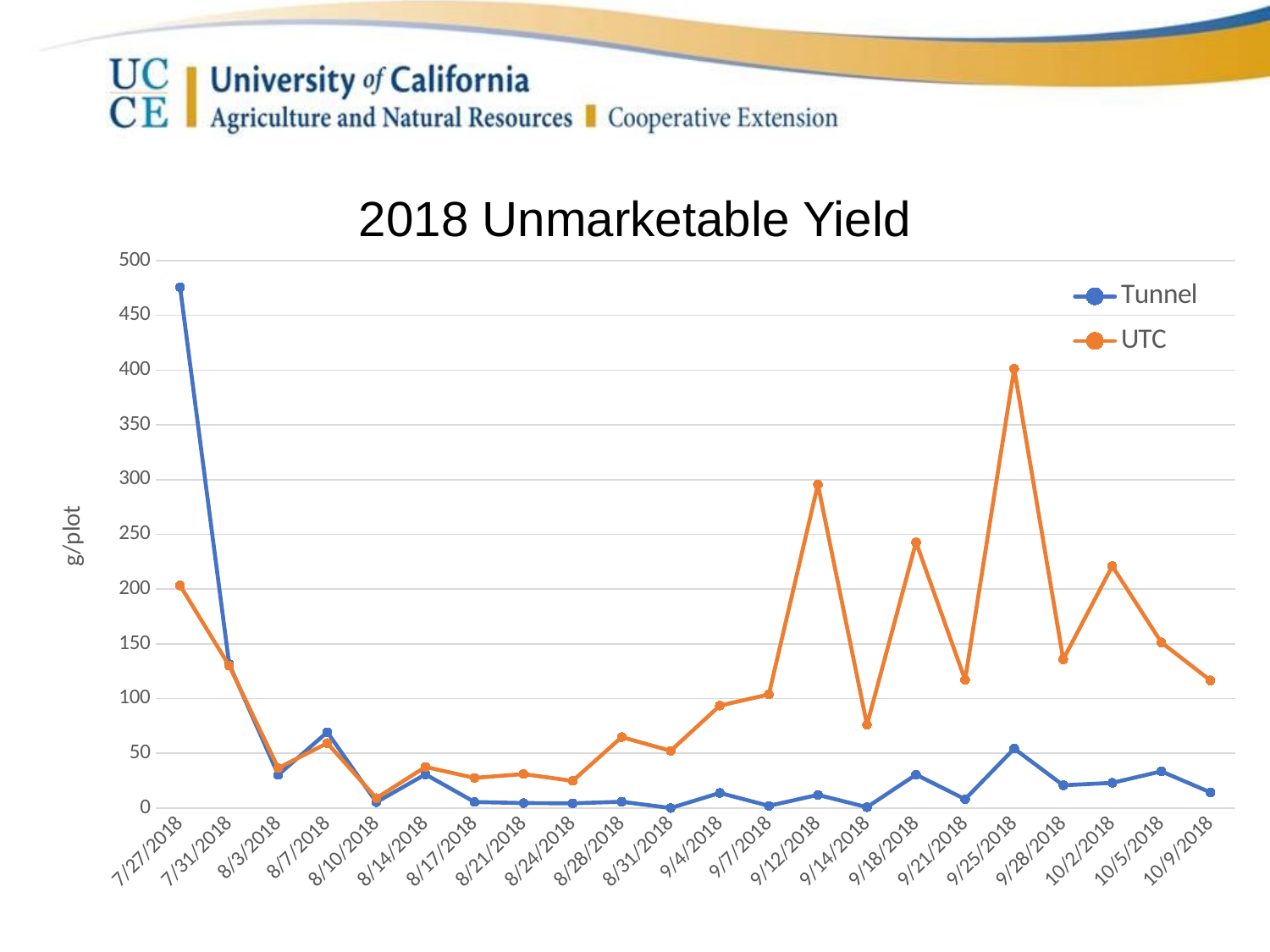
Is the Tunnel value on 9/25/2018 greater or less than 100? less Is the UTC value on 9/25/2018 greater or less than 350? greater Is the Tunnel value on 7/27/2018 greater or less than 450? greater On which date does the UTC series reach its highest value? 9/25/2018 How many dates are plotted along the x axis? 22 Does the Tunnel series rise or fall between 7/27/2018 and 8/3/2018? Fall What is the label on the y axis? g/plot On which date does the Tunnel series reach its highest value? 7/27/2018 How many series does the legend list? 2 What kind of chart is shown on the slide? Line chart On which date does the UTC series reach its lowest value? 8/10/2018 On 9/12/2018, which series has the larger value, Tunnel or UTC? UTC